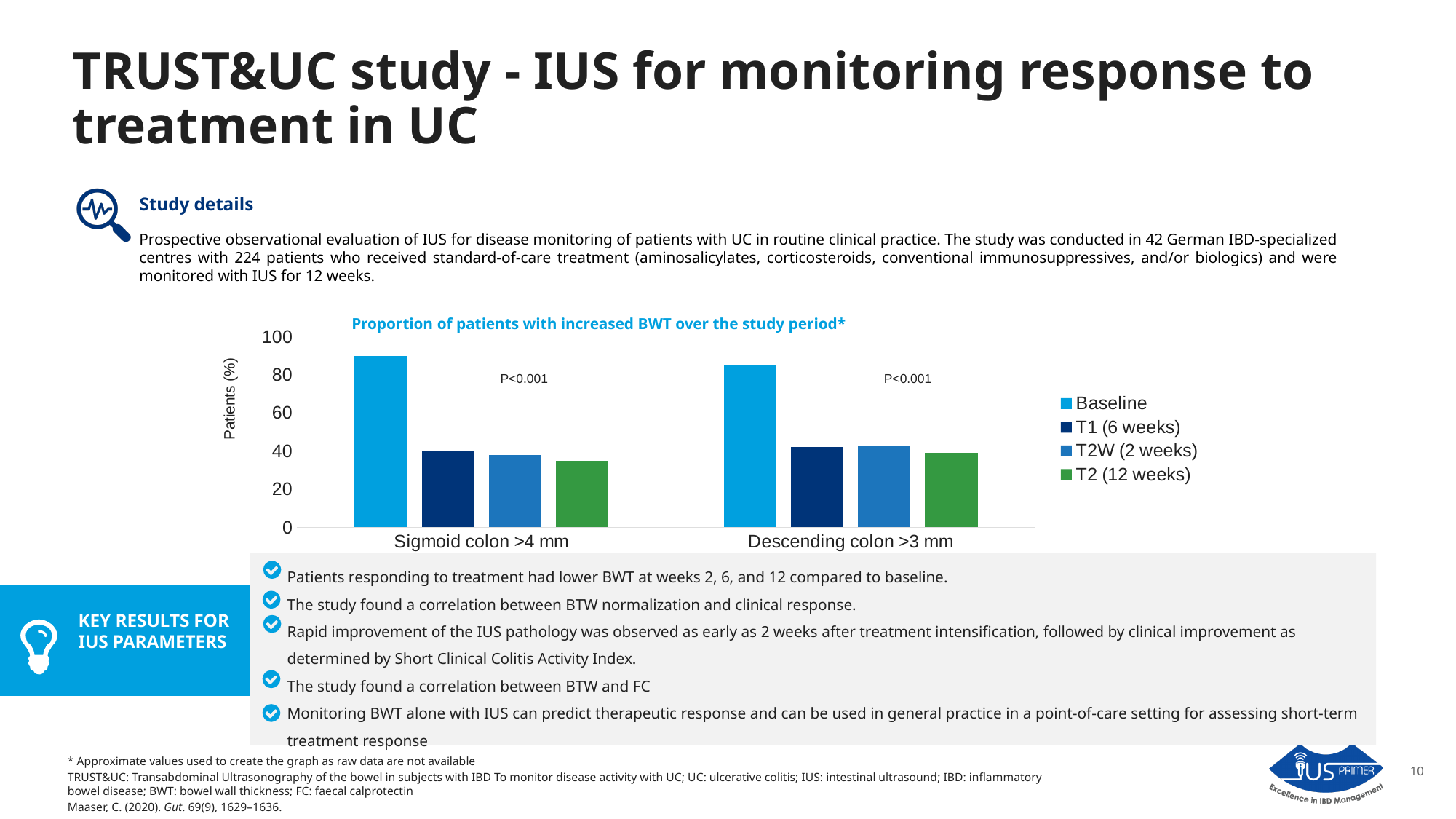
Is the Baseline value for Descending colon >3 mm greater or less than 80? greater Is the T1 (6 weeks) value for Sigmoid colon >4 mm greater or less than 60? less Is the T2 (12 weeks) value for Sigmoid colon >4 mm greater or less than 40? less Which series has the highest value in the Descending colon >3 mm category? Baseline How many series does the chart legend list? 4 How many categories are shown on the x axis of the chart? 2 What is the title of the chart? Proportion of patients with increased BWT over the study period* What is the label of the y axis of the chart? Patients (%) In the Descending colon >3 mm category, which is larger: the Baseline value or the T2 (12 weeks) value? Baseline What kind of chart is shown on the slide? Bar chart Which series has the highest value in the Sigmoid colon >4 mm category? Baseline